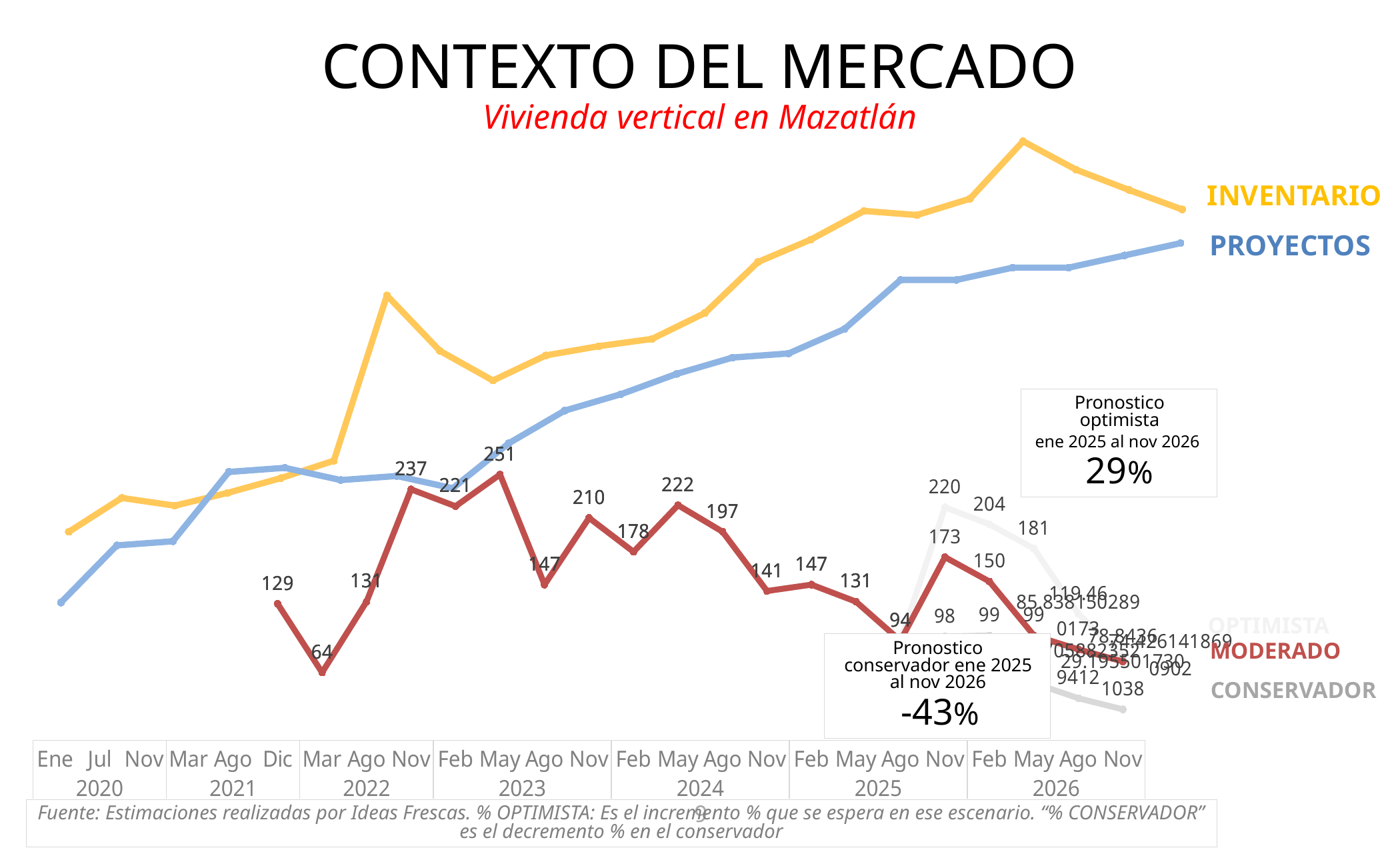
Does the PROYECTOS line generally rise or fall from 2020 to 2026? rise On the MODERADO line, which labelled value is larger: 222 or 197? 222 What percentage is given for the 'Pronostico optimista ene 2025 al nov 2026'? 29% At the right end of the chart, which line is higher: INVENTARIO or PROYECTOS? INVENTARIO What is the highest labelled value on the MODERADO line? 251 How many series does the chart's legend list? 5 What is the first labelled value on the MODERADO line? 129 What is the difference between the highest (251) and lowest (64) labelled values on the MODERADO line? 187 What percentage is given for the 'Pronostico conservador ene 2025 al nov 2026'? -43% What is the lowest labelled value on the MODERADO line? 64 What kind of chart is shown on the slide? line chart